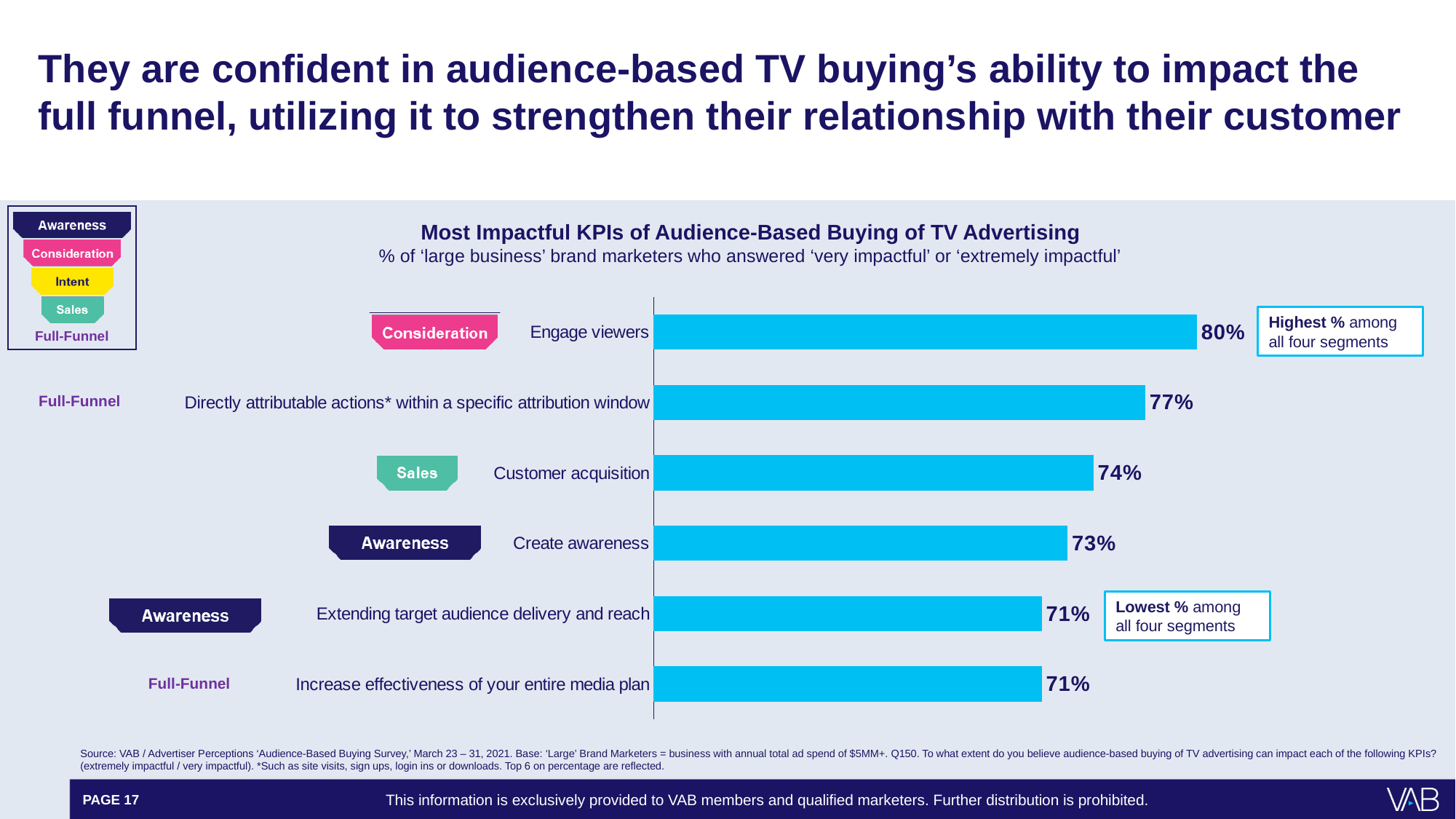
What is the difference between the values for 'Customer acquisition' and 'Create awareness'? 1% Which has a larger value: 'Directly attributable actions* within a specific attribution window' or 'Customer acquisition'? Directly attributable actions* within a specific attribution window What is the value shown for 'Customer acquisition'? 74% Which KPI has the highest percentage in the chart? Engage viewers Which funnel segment label is shown next to 'Customer acquisition'? Sales What is the title of the chart? Most Impactful KPIs of Audience-Based Buying of TV Advertising What percentage of large business brand marketers rated 'Engage viewers' as very or extremely impactful? 80% What is the value shown for 'Create awareness'? 73% How many KPIs are shown in the chart? 6 What is the difference between the values for 'Engage viewers' and 'Increase effectiveness of your entire media plan'? 9% What is the value shown for 'Directly attributable actions* within a specific attribution window'? 77% What type of chart is used on this slide? Bar chart